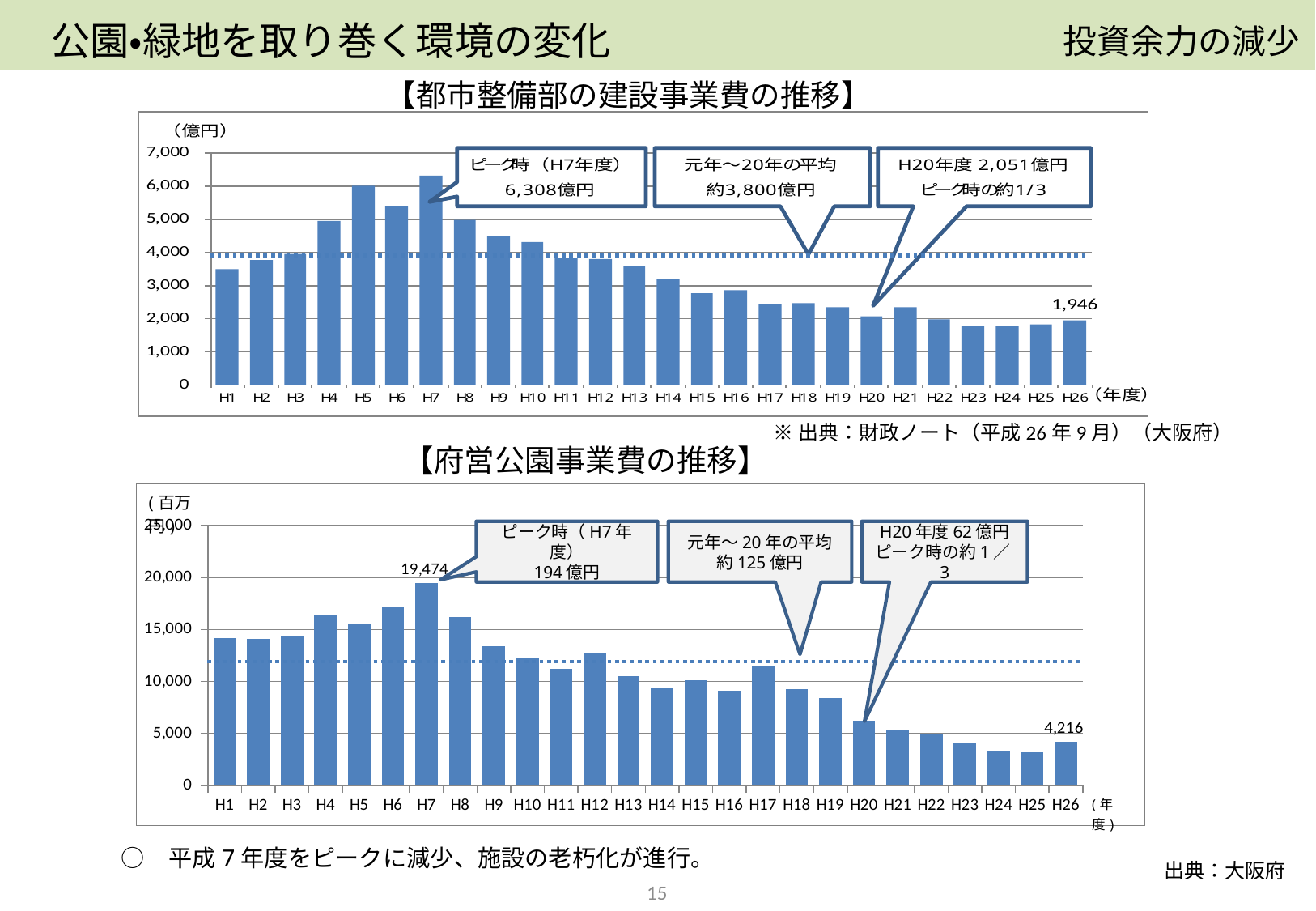
In the top chart (都市整備部の建設事業費の推移), which is larger, the value for H1 or the value for H7? H7 In the bottom chart (府営公園事業費の推移), is the value for H17 greater or less than 10,000? greater In the top chart (都市整備部の建設事業費の推移), do the values generally rise or fall from H7 to H26? Fall What kind of chart is the bottom chart (府営公園事業費の推移)? Bar chart In the bottom chart (府営公園事業費の推移), what is the value for H26? 4,216 In the top chart (都市整備部の建設事業費の推移), what is the value for H26? 1,946 In the bottom chart (府営公園事業費の推移), what is the difference between the H7 value and the H26 value? 15,258 How many fiscal years are plotted on the x axis of the top chart (都市整備部の建設事業費の推移)? 26 In the bottom chart (府営公園事業費の推移), what is the value for H7? 19,474 In the top chart (都市整備部の建設事業費の推移), is the value for H5 greater or less than 5,000? greater In the bottom chart (府営公園事業費の推移), which fiscal year has the highest value? H7 In the top chart (都市整備部の建設事業費の推移), which fiscal year has the highest value? H7